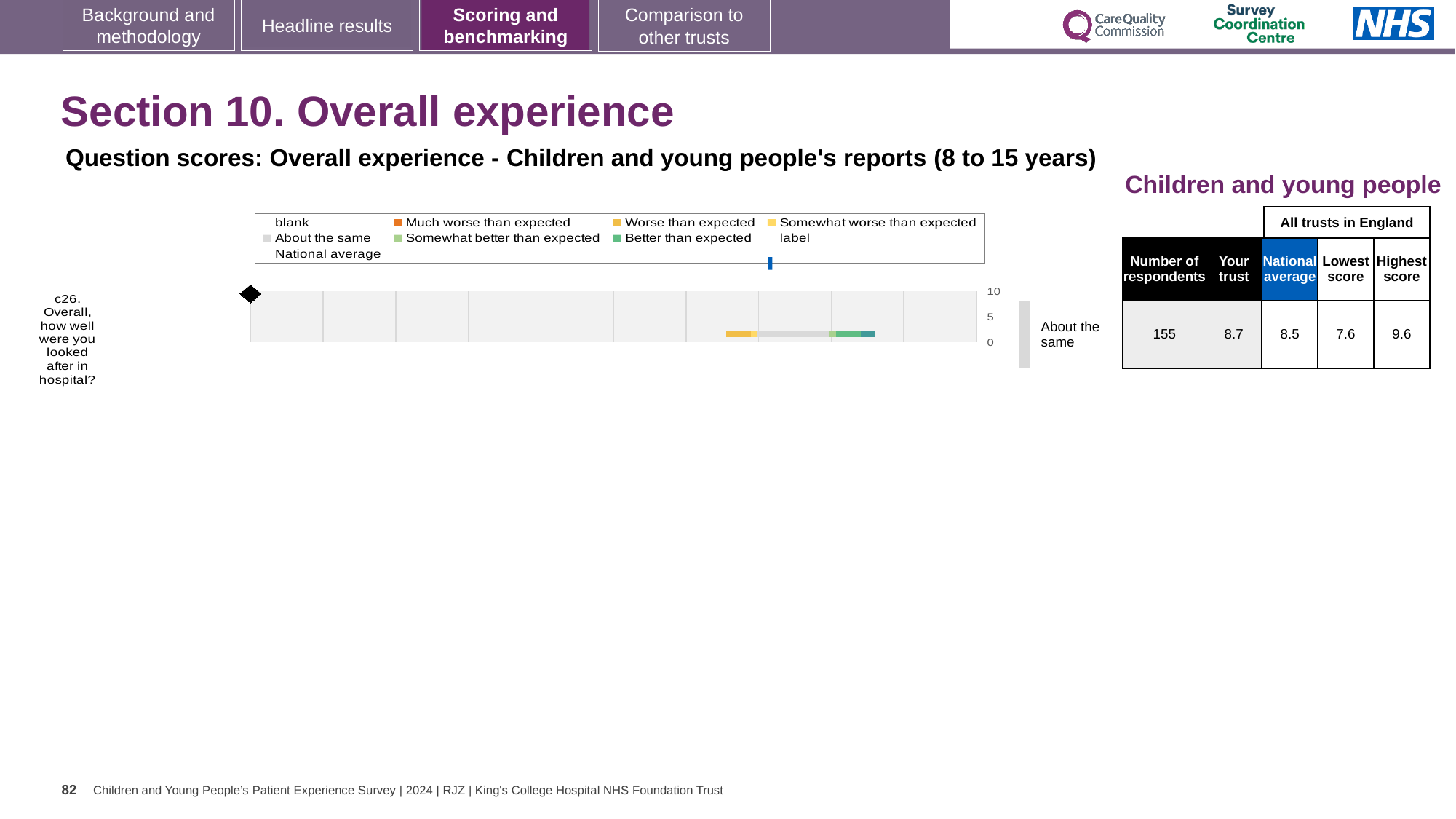
How many questions are plotted in the chart? 1 What is the lowest score among all trusts in England for question c26? 7.6 What kind of chart is used to show the score for question c26? bar chart What is the national average score for question c26? 8.5 What benchmark category label is shown next to the bar for question c26? About the same Which is larger for question c26: the 'Your trust' score or the national average? Your trust How many respondents answered question c26? 155 What is the 'Your trust' score for question c26 shown in the table next to the chart? 8.7 What is the highest score among all trusts in England for question c26? 9.6 What is the maximum value shown on the chart's vertical axis? 10 What is the difference between the highest score and the lowest score for question c26? 2.0 How many entries does the chart legend list? 9